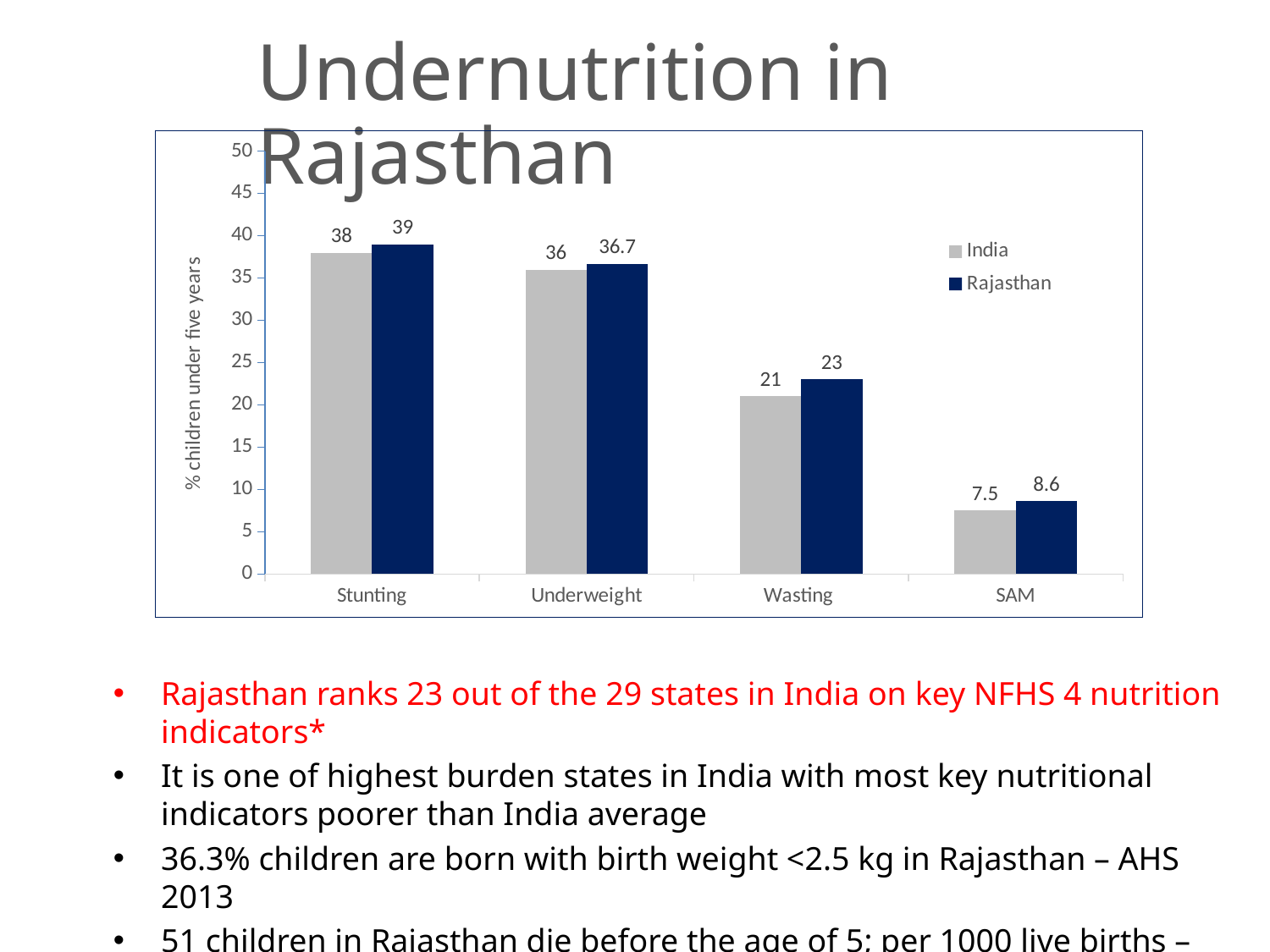
Which category has the lowest value for Rajasthan? SAM What is the value for Rajasthan in the Stunting category? 39 What is the value for Rajasthan in the SAM category? 8.6 What is the value for India in the Wasting category? 21 What is the difference between the Rajasthan and India values for Wasting? 2 Which is larger for SAM, the India value or the Rajasthan value? Rajasthan How many categories are shown on the x axis? 4 What kind of chart is shown on the slide? Bar chart Which category has the highest value for India? Stunting What is the difference between the Rajasthan and India values for Underweight? 0.7 How many series does the legend list? 2 What is the label of the y axis? % children under five years